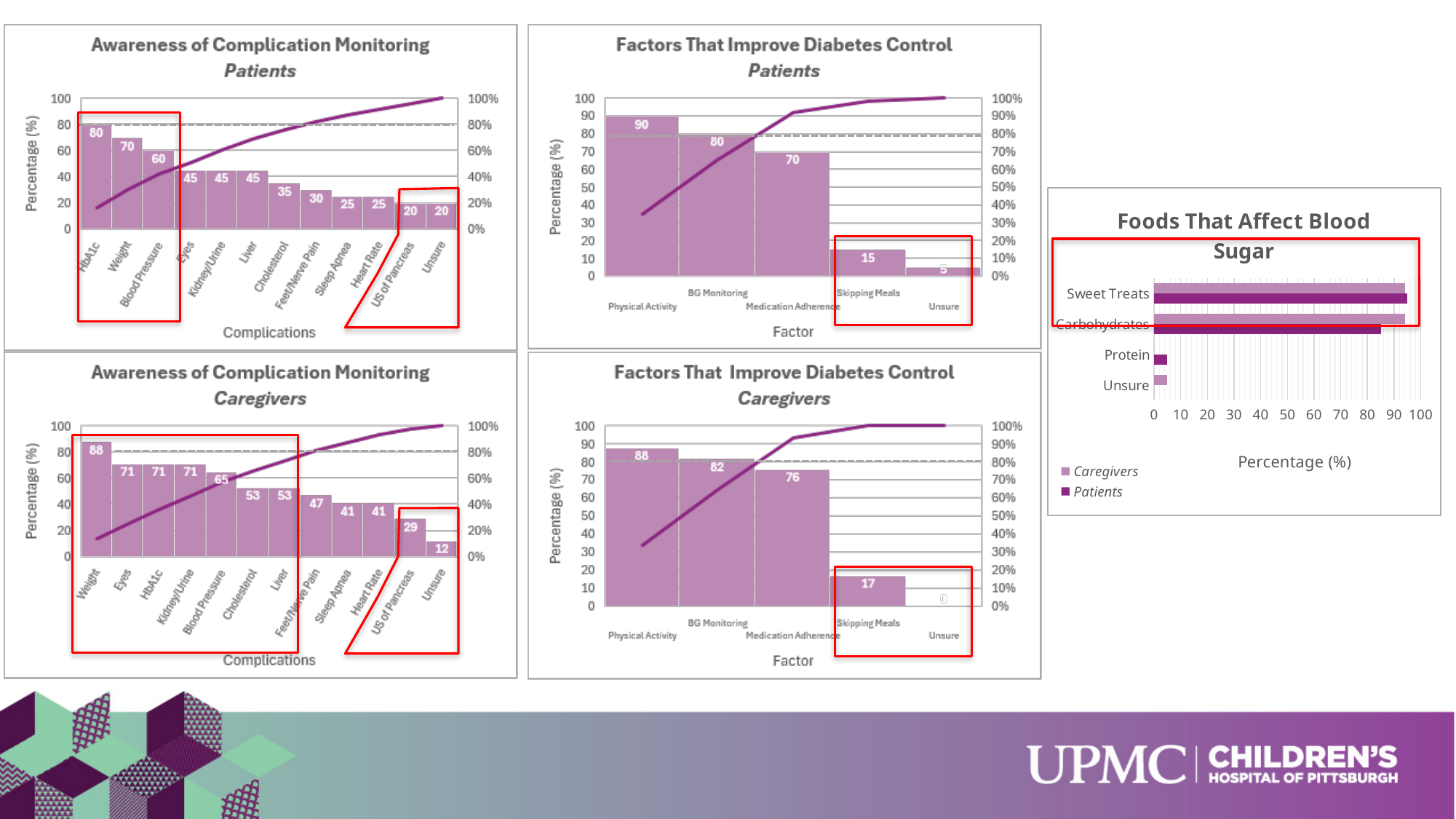
In the 'Awareness of Complication Monitoring – Patients' chart, which complication has the highest bar? HbA1c In the 'Foods That Affect Blood Sugar' chart, is the Patients value for Protein greater or less than 20? less In the 'Factors That Improve Diabetes Control – Caregivers' chart, how many factor categories are shown? 5 In the 'Factors That Improve Diabetes Control – Patients' chart, what is the value for Skipping Meals? 15 In the 'Factors That Improve Diabetes Control – Patients' chart, what is the difference between Physical Activity and Medication Adherence? 20 In the 'Awareness of Complication Monitoring – Caregivers' chart, which complication has the lowest bar? Unsure In the 'Awareness of Complication Monitoring – Caregivers' chart, what is the value for Weight? 88 In the 'Awareness of Complication Monitoring – Patients' chart, how many complication categories are shown on the x axis? 12 In the 'Foods That Affect Blood Sugar' chart, how many series does the legend list? 2 In the 'Awareness of Complication Monitoring – Patients' chart, what is the value for HbA1c? 80 In the 'Factors That Improve Diabetes Control – Caregivers' chart, what is the value for BG Monitoring? 82 In the 'Awareness of Complication Monitoring – Caregivers' chart, which is larger, the value for Cholesterol or the value for Feet/Nerve Pain? Cholesterol